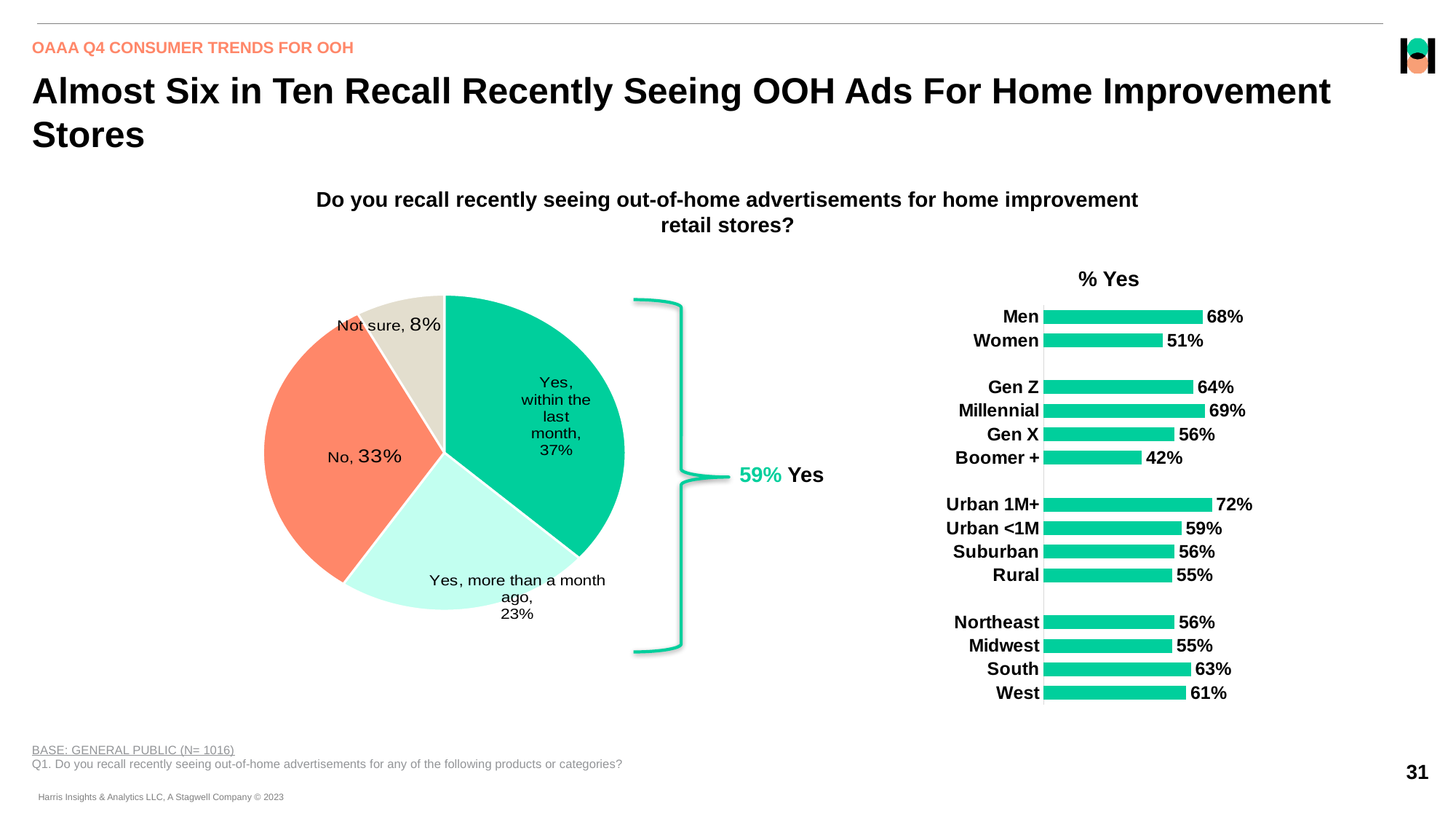
In the pie chart on the left, what share of respondents answered "No"? 33% In the "% Yes" bar chart on the right, what is the value for Boomer +? 42% In the "% Yes" bar chart on the right, what is the value for Urban 1M+? 72% In the pie chart on the left, how many slices are there? 4 In the "% Yes" bar chart on the right, which has a higher value, South or Midwest? South In the pie chart on the left, which response has the smallest slice? Not sure In the "% Yes" bar chart on the right, which category has the lowest value? Boomer + In the "% Yes" bar chart on the right, what is the difference between the values for Men and Women? 17% What kind of chart is the "% Yes" chart on the right of the slide? Bar chart In the pie chart on the left, what share of respondents answered "Yes, within the last month"? 37% What kind of chart is the chart on the left of the slide? Pie chart In the "% Yes" bar chart on the right, which category has the highest value? Urban 1M+